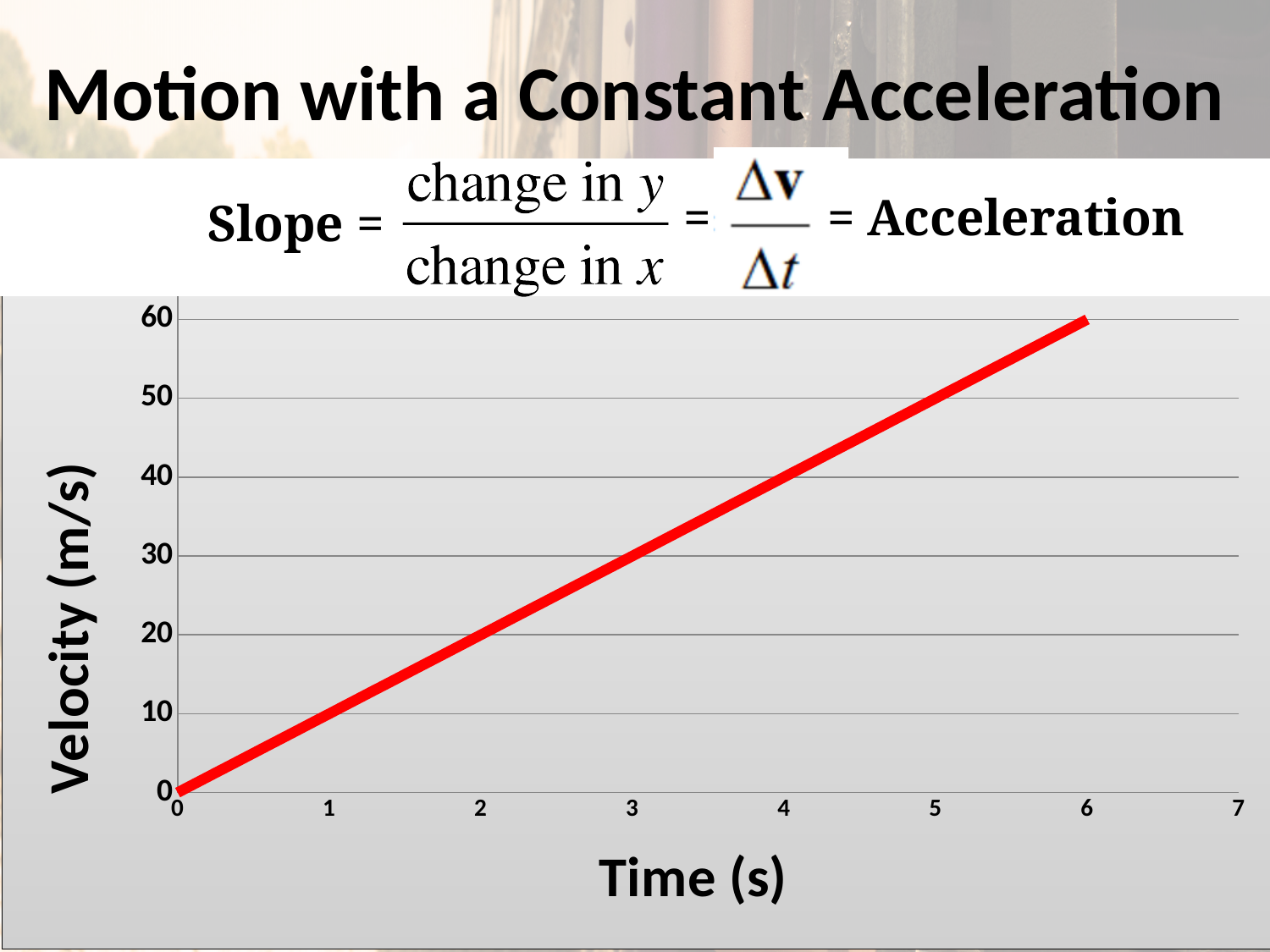
What is the highest value shown on the y axis? 60 What is the velocity at time 0 s? 0 What is the velocity at time 6 s? 60 Is the velocity at time 2 s greater or less than 30? less What kind of chart is shown on the slide? line chart Is the velocity at time 5 s greater or less than 40? greater Is the velocity at time 1 s greater or less than 20? less What is the difference between the velocity at time 6 s and the velocity at time 0 s? 60 Which is larger, the velocity at time 4 s or the velocity at time 2 s? time 4 s What is the label of the y axis? Velocity (m/s) Does the velocity rise or fall as time increases? rise What is the label of the x axis? Time (s)